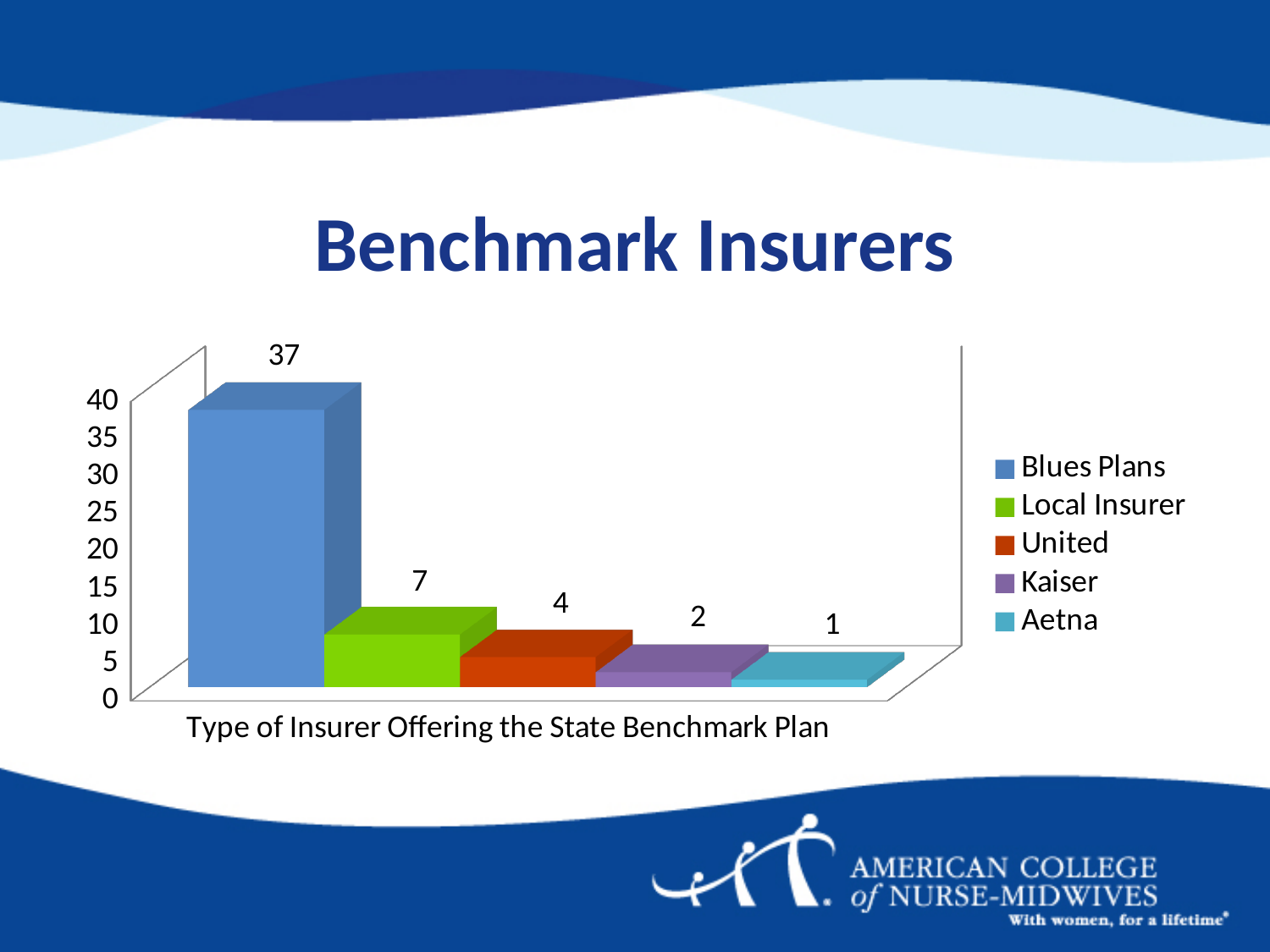
What is the value for Blues Plans? 37 Which insurer type has the highest value? Blues Plans How many series does the legend list? 5 Which insurer type has the lowest value? Aetna What kind of chart is shown on the slide? Bar chart What is the title of the slide containing the chart? Benchmark Insurers What is the value for Aetna? 1 Which is larger, the value for United or the value for Kaiser? United What is the value for United? 4 What is the value for Kaiser? 2 What is the difference between the values for Blues Plans and Local Insurer? 30 What is the value for Local Insurer? 7